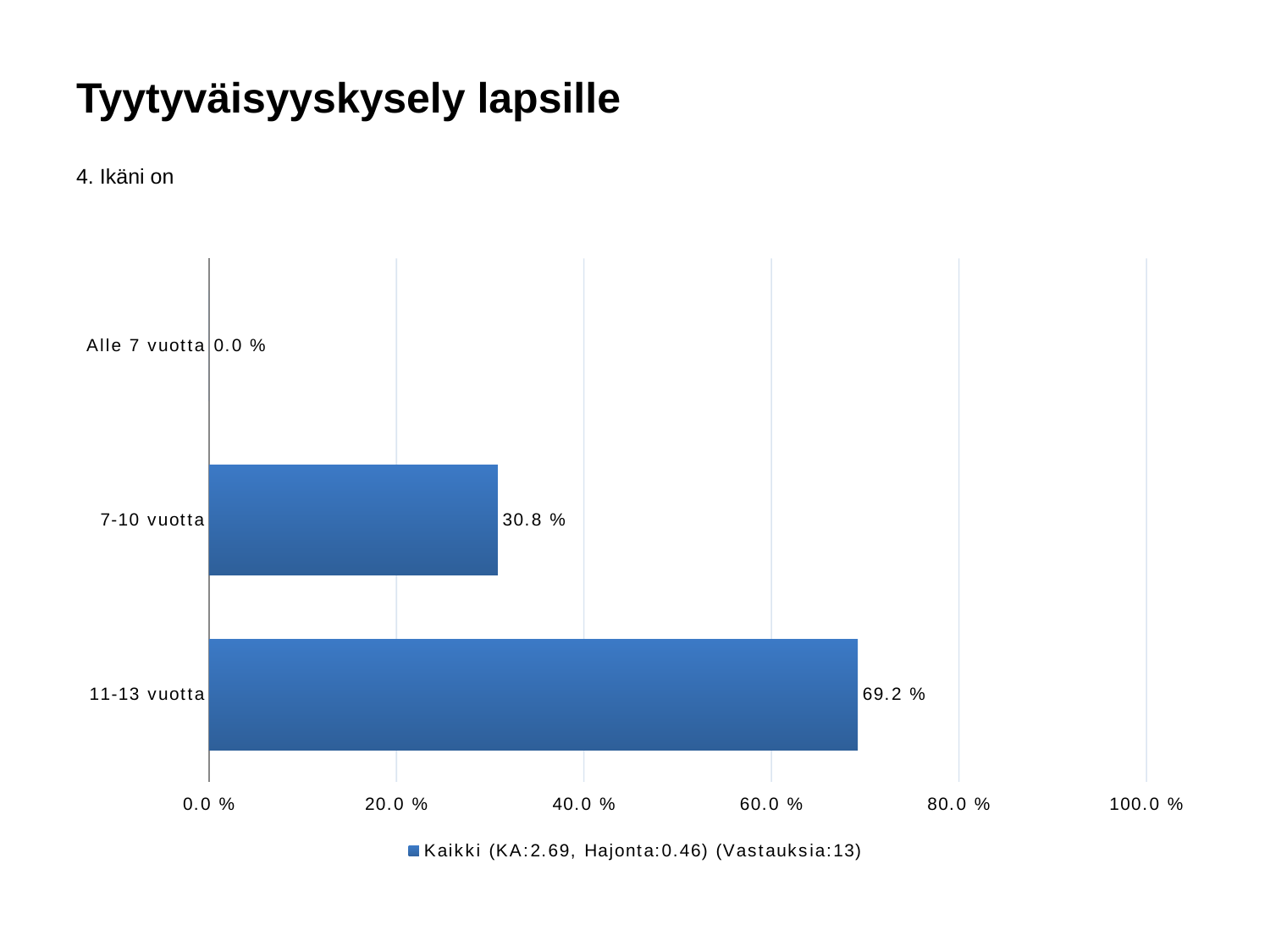
How many categories are shown in the chart? 3 What is the difference between the values for 11-13 vuotta and 7-10 vuotta? 38.4 % What is the legend entry of the chart? Kaikki (KA:2.69, Hajonta:0.46) (Vastauksia:13) Which category has the lowest value? Alle 7 vuotta What is the value for 7-10 vuotta? 30.8 % What is the value for 11-13 vuotta? 69.2 % How many series does the legend list? 1 What is the value for Alle 7 vuotta? 0.0 % Which is larger, the value for 7-10 vuotta or the value for 11-13 vuotta? 11-13 vuotta Is the value for 11-13 vuotta greater or less than 60.0 %? greater What kind of chart is shown on the slide? bar chart Which category has the highest value? 11-13 vuotta